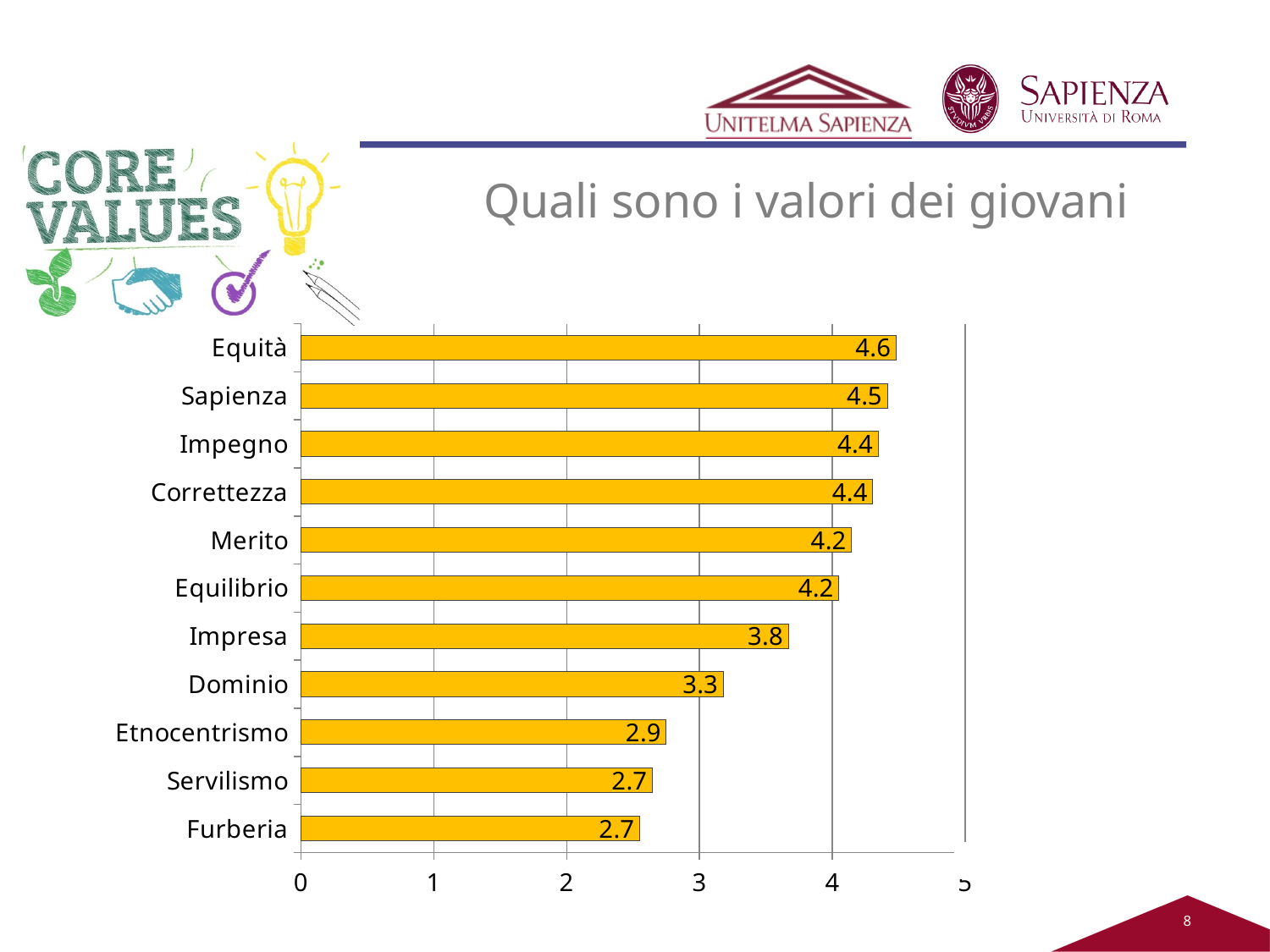
What is the title of the slide containing the chart? Quali sono i valori dei giovani What is the value for Etnocentrismo? 2.9 What is the value for Equità? 4.6 Which has a larger value, Impresa or Dominio? Impresa What is the difference between the values for Impresa and Dominio? 0.5 Is the value for Dominio greater or less than 3? greater What is the value for Dominio? 3.3 How many categories are shown in the chart? 11 Which category has the highest value? Equità What is the difference between the values for Equità and Furberia? 1.9 What is the value for Impresa? 3.8 What kind of chart is shown on the slide? bar chart